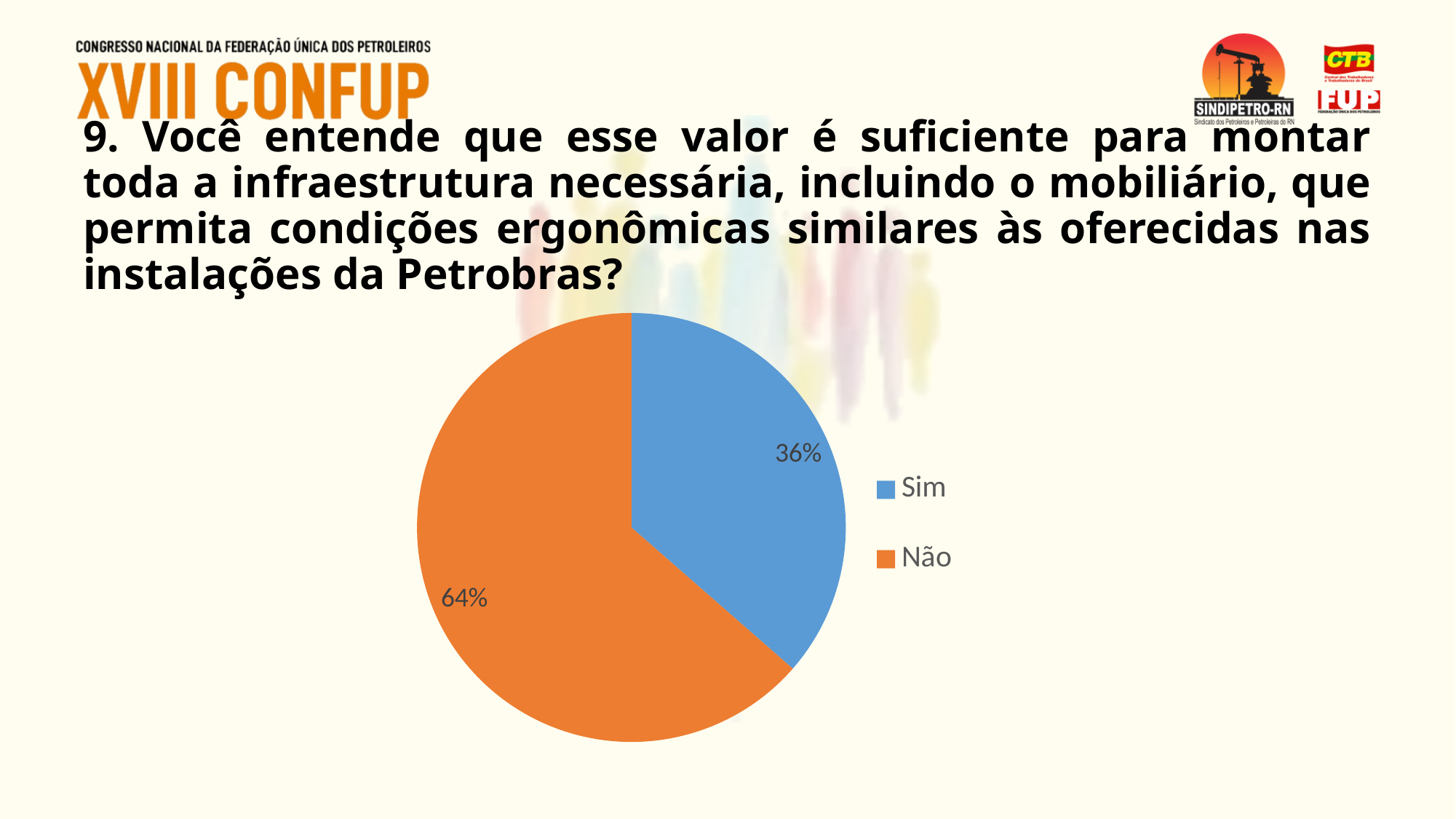
What percentage of the pie chart is labelled "Sim"? 36% Which slice of the pie chart is the largest? Não What colour is the "Sim" slice in the pie chart? Blue How many slices does the pie chart have? 2 What colour is the "Não" slice in the pie chart? Orange Which is larger, the "Sim" slice or the "Não" slice? Não What share of the pie does the "Sim" slice represent? 36% Which slice of the pie chart is the smallest? Sim What is the difference in percentage points between the "Não" and "Sim" slices? 28 What percentage of the pie chart is labelled "Não"? 64% How many entries does the legend list? 2 What kind of chart is shown on the slide? Pie chart